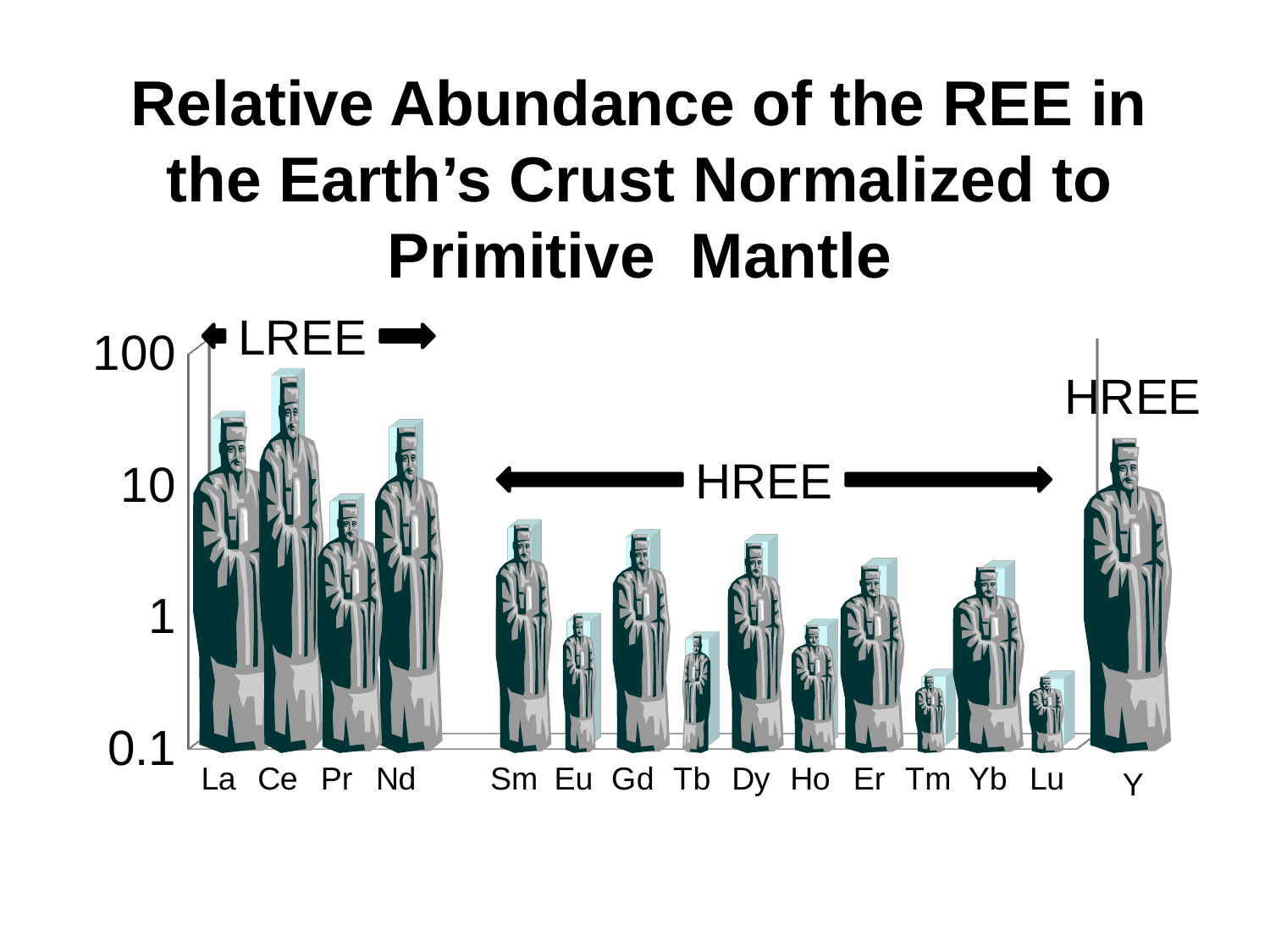
Which has the larger value, Nd or Pr? Nd Is the value for La greater or less than 10? greater Is the value for Ce greater or less than 10? greater What is the title of the chart on the slide? Relative Abundance of the REE in the Earth's Crust Normalized to Primitive Mantle Which element has the highest relative abundance on the chart? Ce Which has the larger value, Ce or La? Ce Is the value for Sm greater or less than 1? greater How many elements (categories) are plotted along the x axis? 15 Which has the larger value, Sm or Eu? Sm What kind of chart is shown on the slide? bar chart